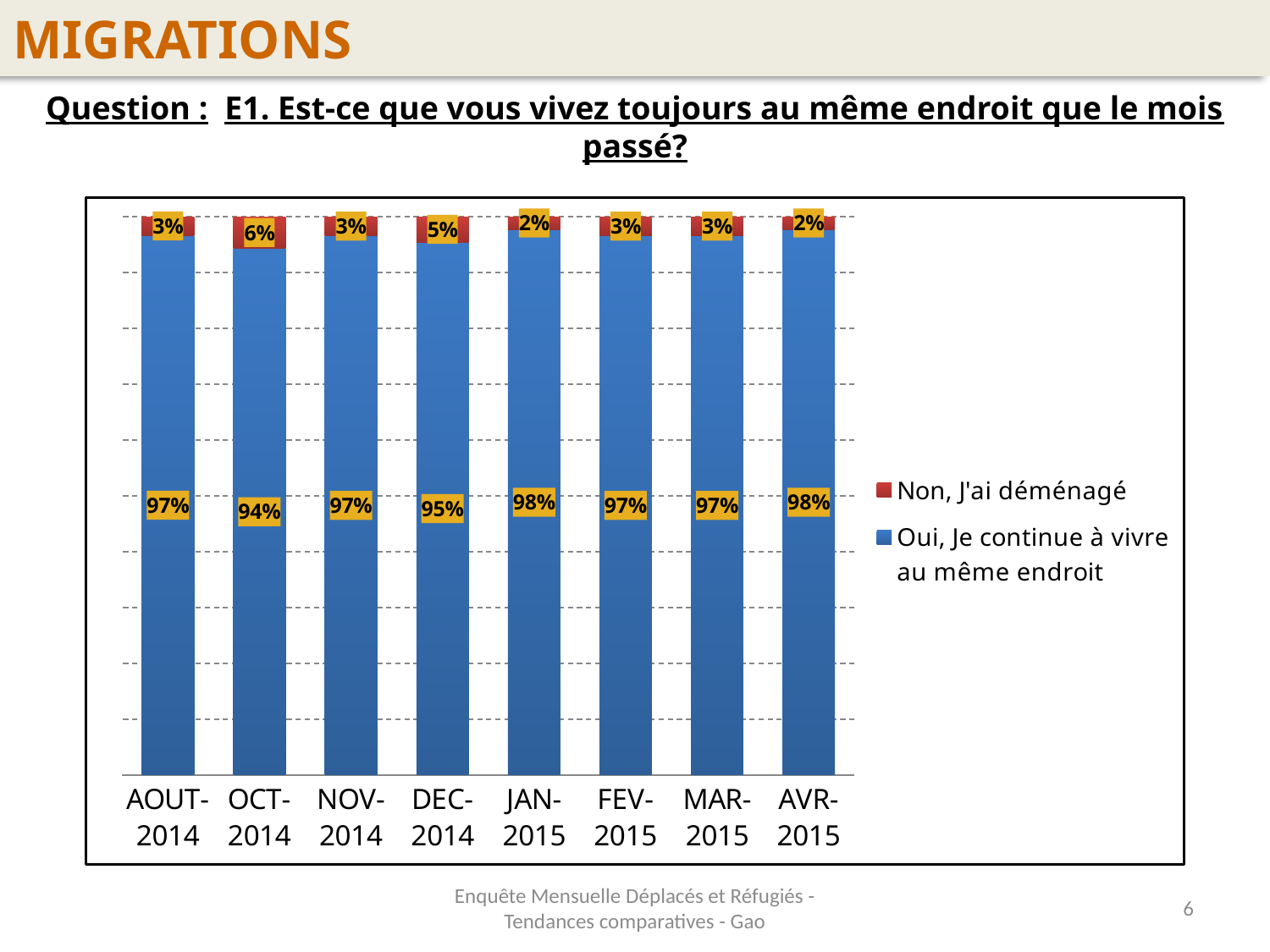
What percentage answered "Oui, Je continue à vivre au même endroit" in OCT-2014? 94% In which month is the share of "Non, J'ai déménagé" the highest? OCT-2014 What kind of chart is shown on the slide? Stacked bar chart What percentage answered "Non, J'ai déménagé" in DEC-2014? 5% Which is larger: the "Non, J'ai déménagé" share in DEC-2014 or in FEV-2015? DEC-2014 What is the total of the stacked bar for NOV-2014? 100% What is the difference between the "Oui" share in JAN-2015 and the "Oui" share in OCT-2014? 4% How many series does the legend list? 2 In which month is the share of "Oui, Je continue à vivre au même endroit" the lowest? OCT-2014 How many months are shown on the x axis? 8 What is the value for "Oui, Je continue à vivre au même endroit" in AVR-2015? 98% Which colour represents "Non, J'ai déménagé" in the legend? Red